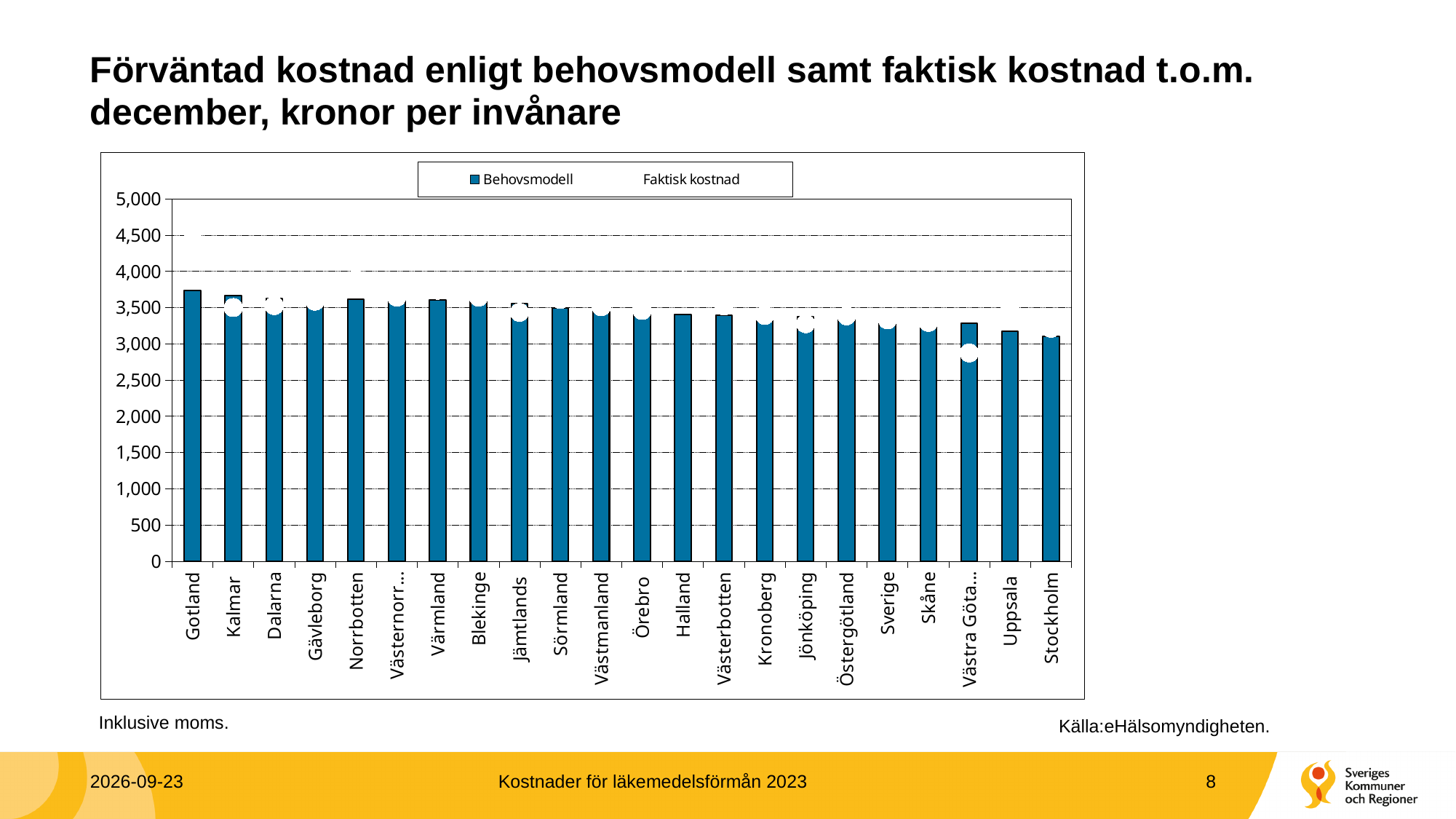
Do the Behovsmodell bars generally rise or fall from left to right along the x axis? fall Is the Behovsmodell value for Gotland greater or less than 3,500? greater Is the Faktisk kostnad value for Västra Götaland greater or less than 3,000? less How many categories are shown on the x axis? 22 Is the Behovsmodell value for Stockholm greater or less than 3,500? less What kind of chart is shown on the slide? bar chart Which has the larger Behovsmodell value, Gotland or Stockholm? Gotland How many series does the legend list? 2 What are the two series named in the legend? Behovsmodell and Faktisk kostnad Which category has the lowest Behovsmodell bar? Stockholm Which category has the highest Behovsmodell bar? Gotland